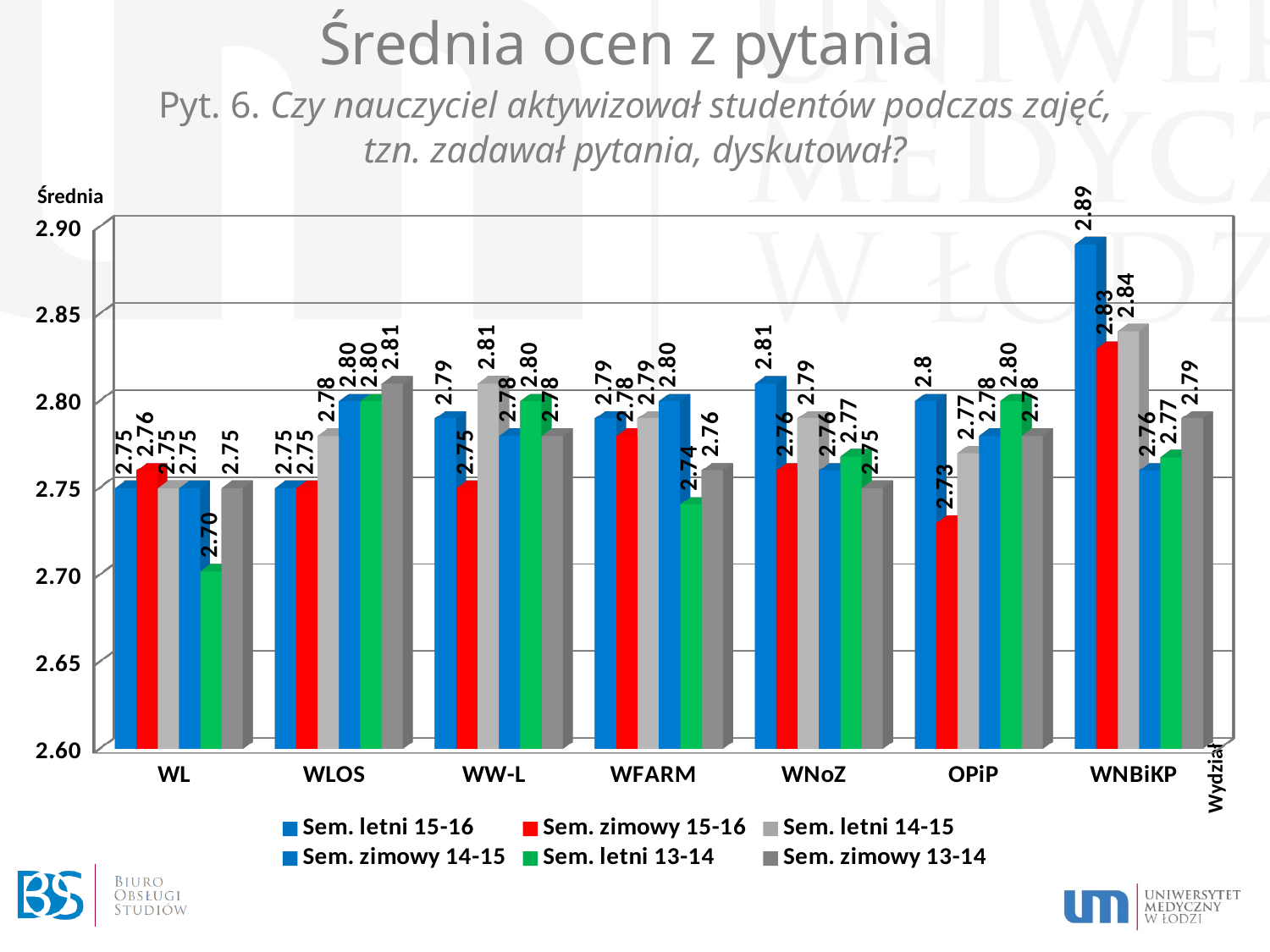
For Sem. zimowy 13-14, which is larger: WLOS or WL? WLOS Which faculty has the lowest bar on the chart? WL How many series does the legend list? 6 What is the value for Sem. letni 13-14 at WL? 2.70 What kind of chart is shown on the slide? Bar chart What is the value for Sem. letni 14-15 at WNBiKP? 2.84 What is the value for Sem. zimowy 13-14 at WNoZ? 2.75 What is the value for Sem. zimowy 15-16 at OPiP? 2.73 How many faculties are shown on the x axis? 7 Which faculty has the highest bar on the chart? WNBiKP What is the label of the vertical axis? Średnia What is the difference between Sem. letni 15-16 and Sem. zimowy 15-16 at WNBiKP? 0.06